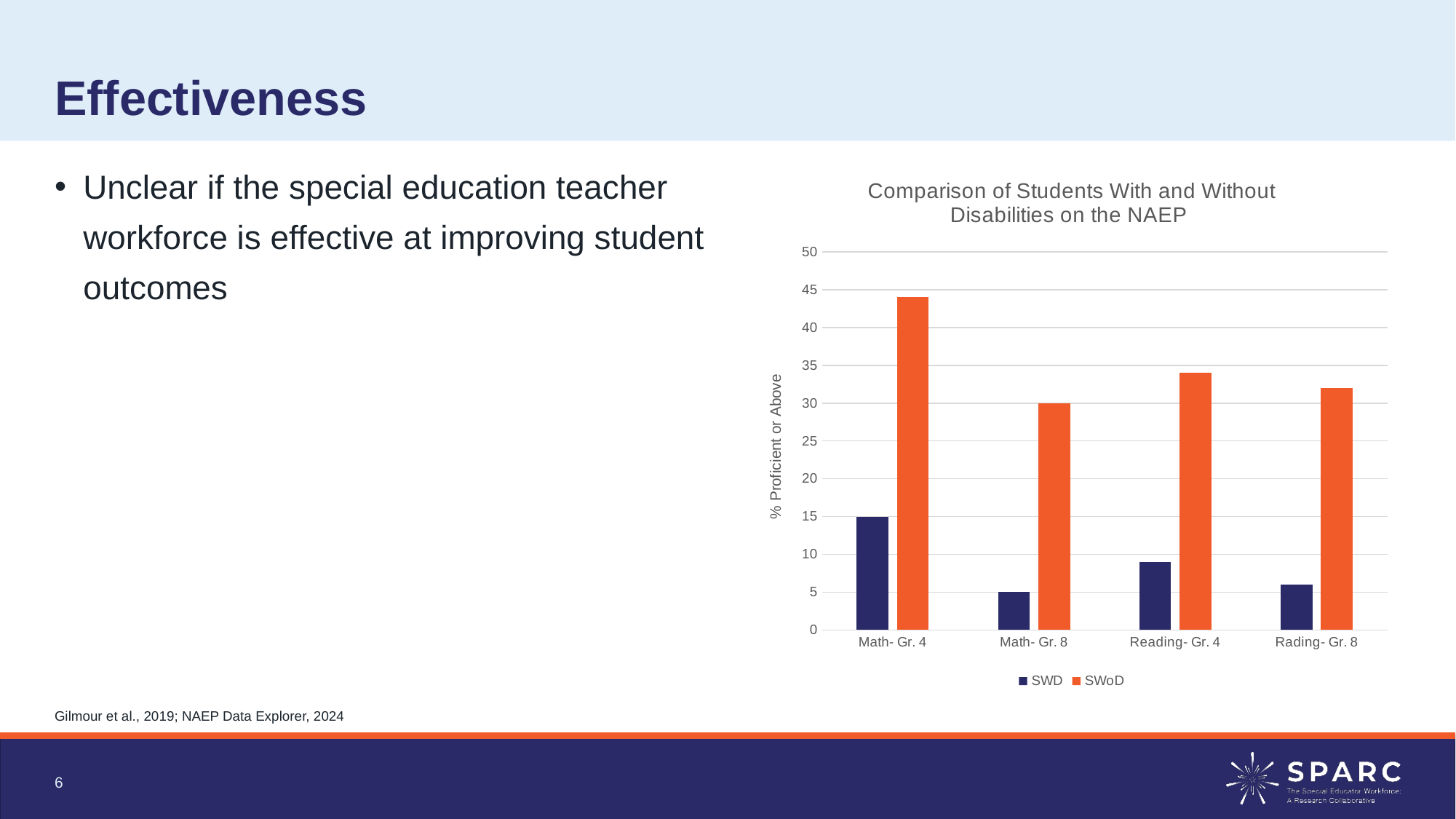
What is the title of the chart? Comparison of Students With and Without Disabilities on the NAEP How many categories are shown on the x axis of the chart? 4 Is the SWoD value for Math- Gr. 4 greater or less than 40? greater What is the SWD value for Math- Gr. 8? 5 Which category has the lowest SWD value? Math- Gr. 8 For Reading- Gr. 4, which series has the larger value, SWD or SWoD? SWoD What is the SWD value for Math- Gr. 4? 15 Is the SWD value for Reading- Gr. 4 greater or less than 10? less What is the SWoD value for Math- Gr. 8? 30 Which category has the highest SWoD value? Math- Gr. 4 How many series does the chart legend list? 2 What type of chart is shown on the slide? bar chart